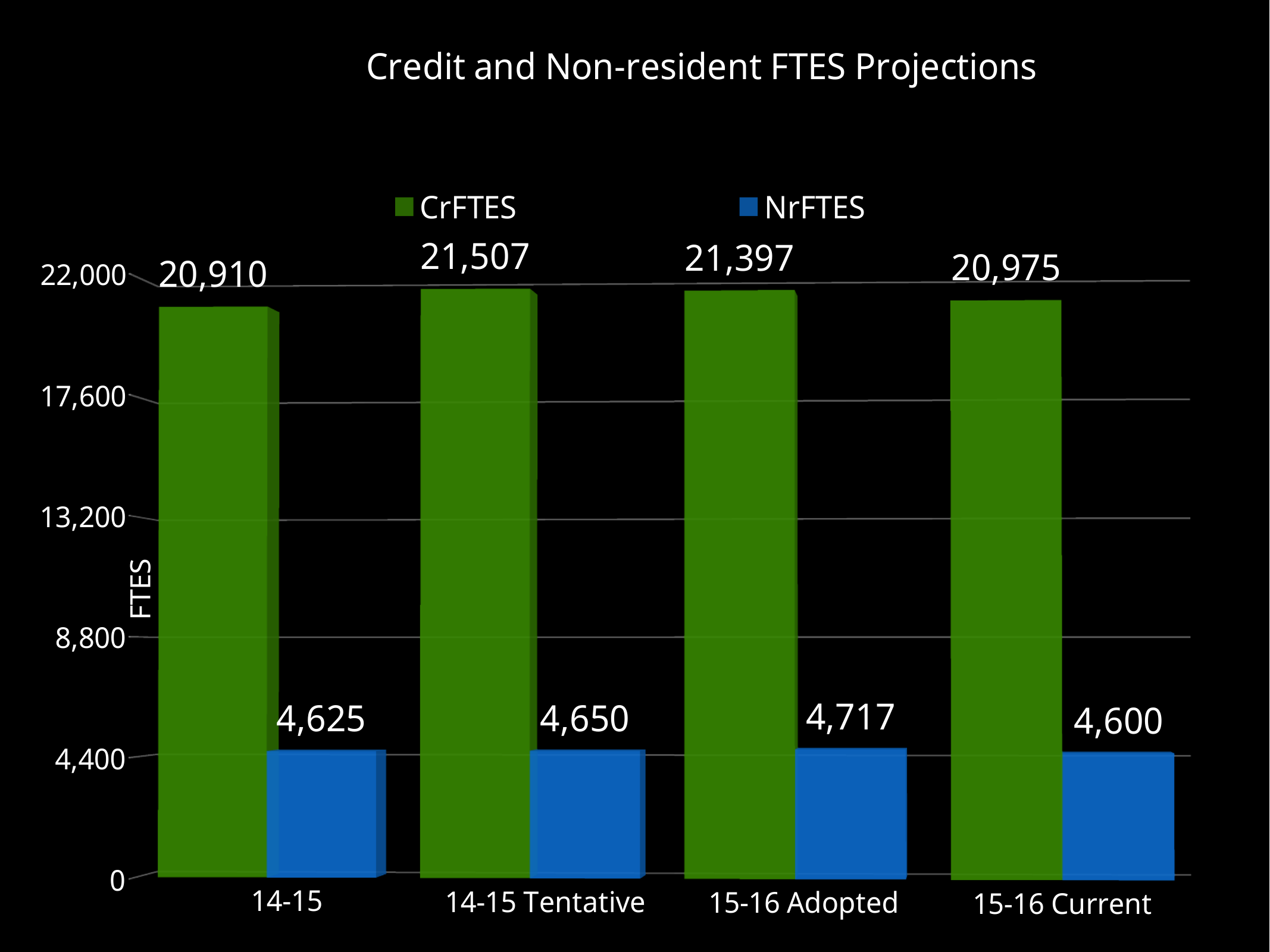
What kind of chart is shown on the slide? bar chart Which is larger, the CrFTES value for 15-16 Adopted or for 15-16 Current? 15-16 Adopted What is the difference between the CrFTES values for 14-15 Tentative and 14-15? 597 How many categories are shown on the x axis? 4 Which category has the lowest NrFTES value? 15-16 Current What is the CrFTES value for 14-15 Tentative? 21,507 Which category has the highest CrFTES value? 14-15 Tentative Is the NrFTES value for 14-15 greater or less than 4,400? greater How many series does the legend list? 2 What is the difference between the NrFTES values for 15-16 Adopted and 15-16 Current? 117 What is the NrFTES value for 15-16 Adopted? 4,717 What is the CrFTES value for 15-16 Current? 20,975